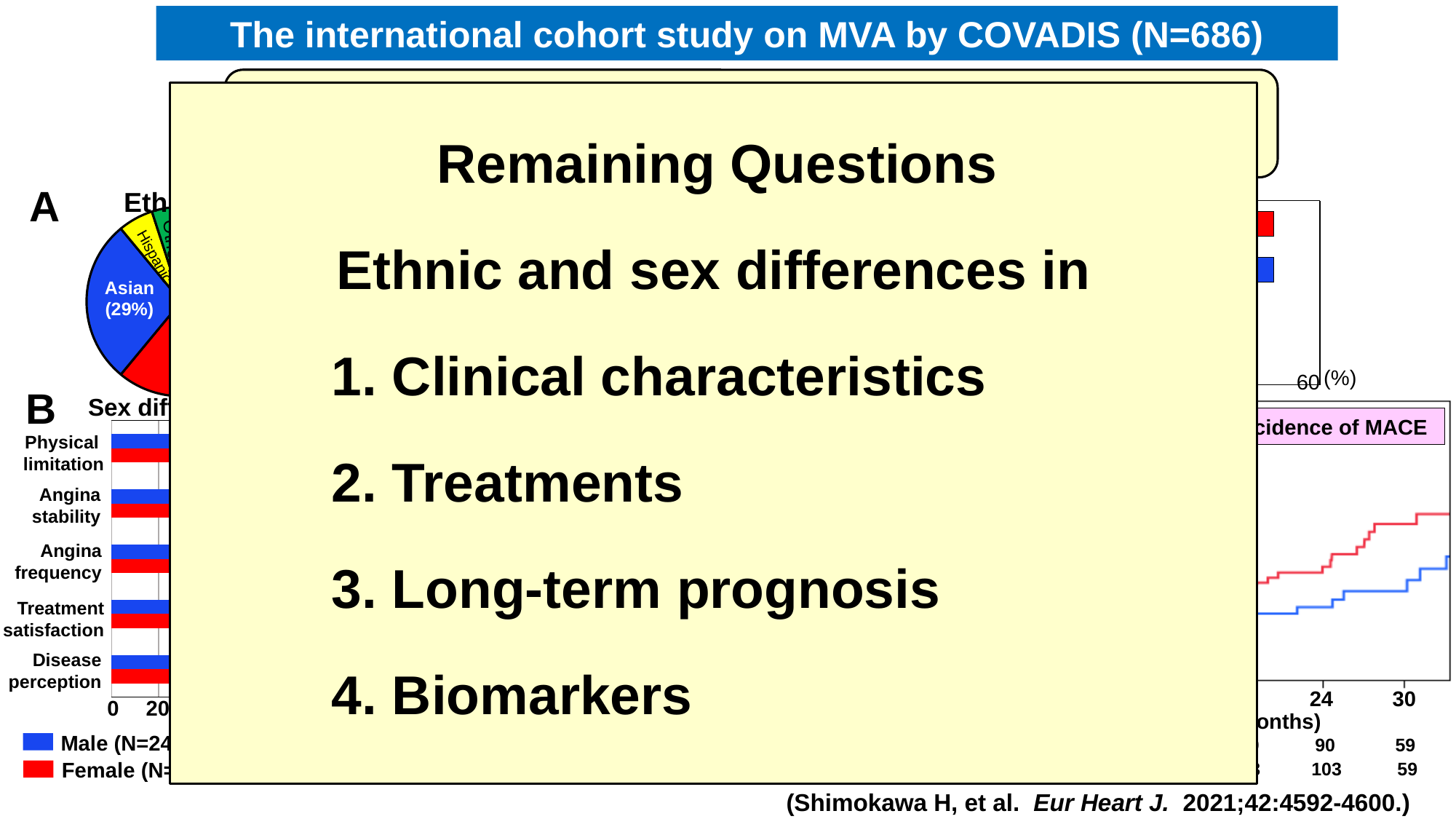
What kind of chart is chart A on the left of the slide? pie chart In the incidence of MACE chart on the right, do the curves rise or fall as months increase? rise In chart B, which colour represents Female in the legend? red In chart A (the pie chart), what percentage share is shown for the Asian slice? 29% In chart B, how many categories are listed on the vertical axis? 5 What kind of chart is chart B on the lower left of the slide? bar chart What kind of chart is the incidence of MACE chart on the right of the slide? line chart In chart B, how many series does the legend list? 2 In chart B, which colour represents Male in the legend? blue In the incidence of MACE chart on the right, which curve is higher at the right end, the red or the blue? red